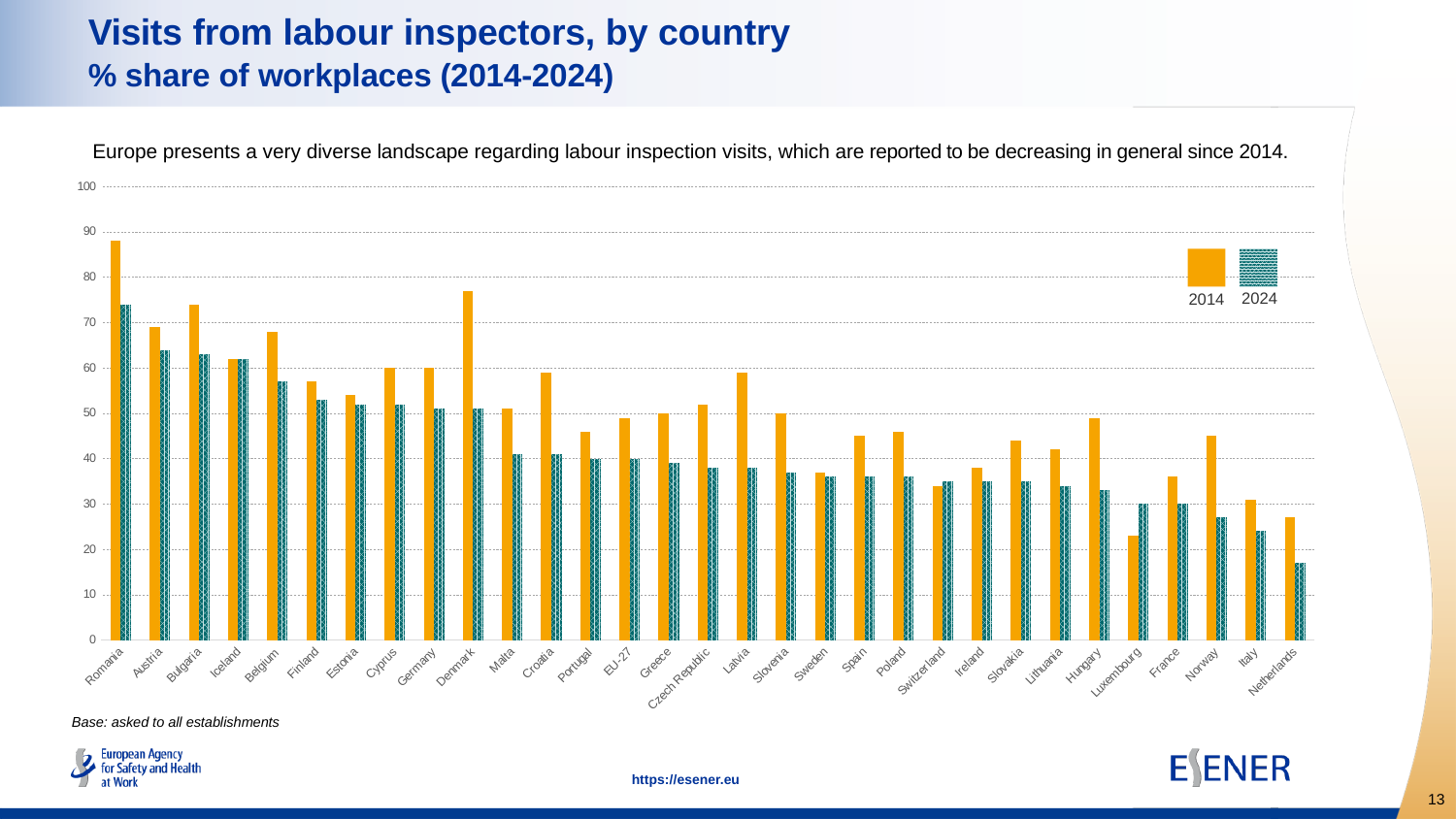
Which country has the lowest value for 2024? Netherlands Do the 2014 values generally rise or fall from left to right along the x axis? fall What kind of chart is shown on the slide? bar chart Which two years are shown in the legend? 2014 and 2024 Which country has the lowest value for 2014? Luxembourg How many countries/categories are shown on the x axis? 31 Is the 2014 value for Romania greater or less than 80? greater Is the 2024 value for Netherlands greater or less than 20? less Which country has the highest value for 2014? Romania Is the 2014 value for Denmark greater or less than 70? greater How many series does the legend list? 2 For Denmark, which year has the larger value, 2014 or 2024? 2014